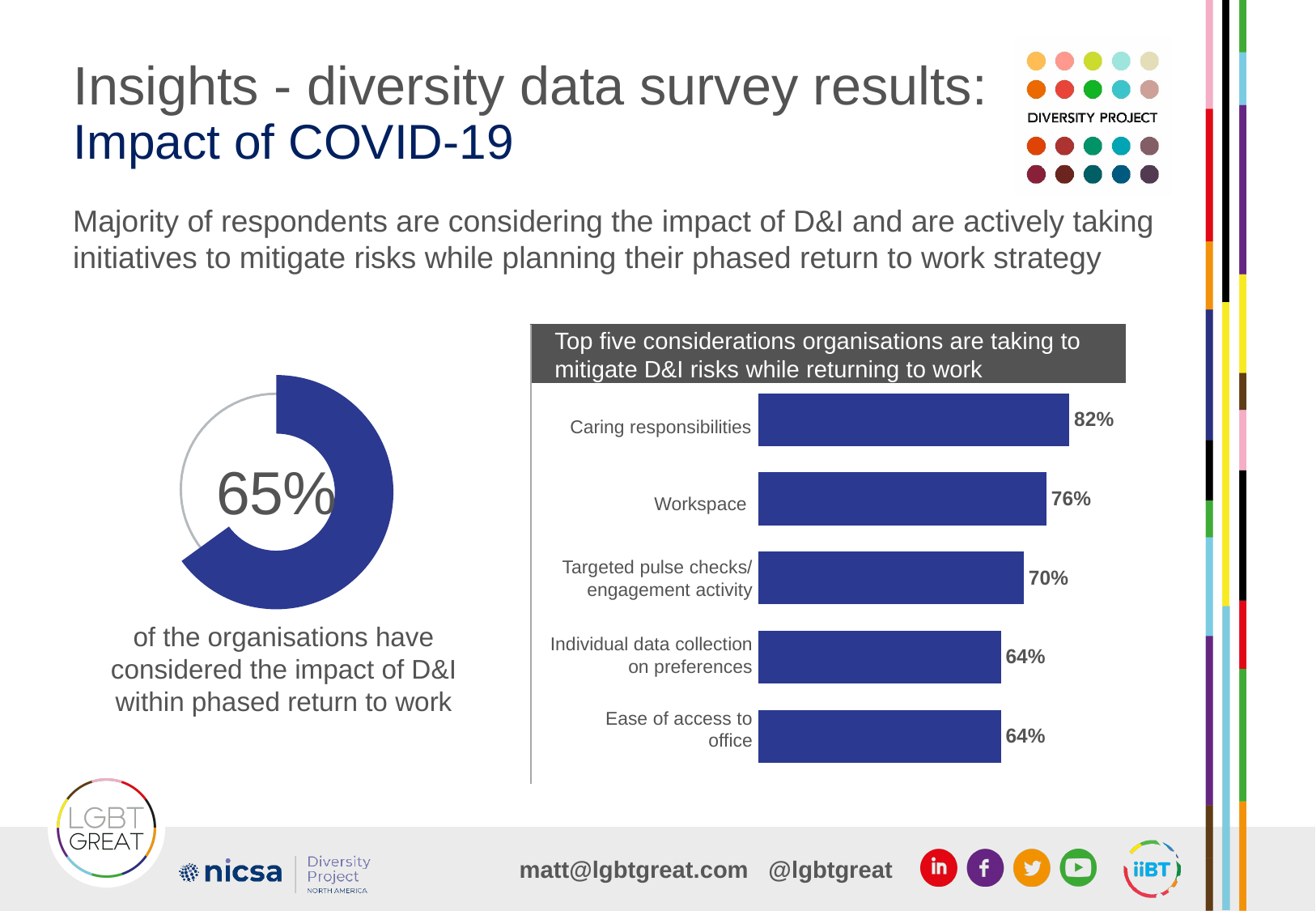
In the bar chart on the right, what is the value for Workspace? 76% In the bar chart on the right, what is the difference between the values for Workspace and Individual data collection on preferences? 12% In the bar chart on the right, which is larger: the value for Workspace or the value for Targeted pulse checks/engagement activity? Workspace In the bar chart on the right, what is the value for Targeted pulse checks/engagement activity? 70% What is the title of the bar chart on the right? Top five considerations organisations are taking to mitigate D&I risks while returning to work How many categories are shown in the bar chart on the right? 5 In the bar chart on the right, what is the value for Caring responsibilities? 82% In the bar chart on the right, which category has the highest value? Caring responsibilities What kind of chart is shown on the right of the slide? Bar chart In the bar chart on the right, what is the value for Ease of access to office? 64% What percentage is shown in the donut chart on the left of the slide? 65% In the bar chart on the right, what is the difference between the values for Caring responsibilities and Workspace? 6%